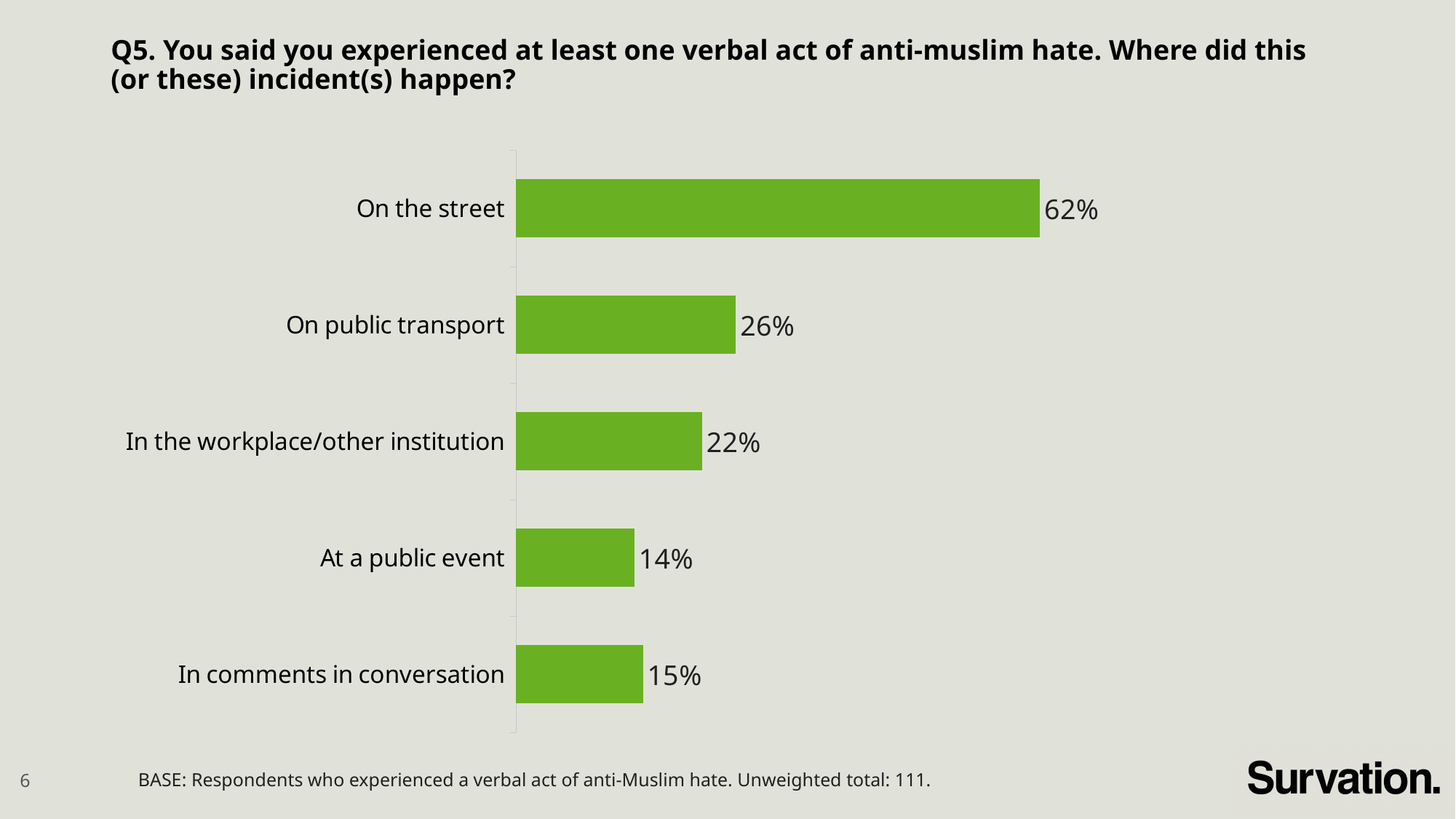
What kind of chart is shown on the slide? Bar chart What is the value for 'In comments in conversation'? 15% How many categories are shown in the chart? 5 What is the difference between the values for 'In comments in conversation' and 'At a public event'? 1% Which location has the lowest percentage? At a public event Which location has the highest percentage? On the street Which is larger: the value for 'On public transport' or 'In the workplace/other institution'? On public transport What is the difference between the values for 'On the street' and 'On public transport'? 36% What percentage is shown for 'In the workplace/other institution'? 22% What is the value for 'On public transport'? 26% What is the unweighted total of respondents stated in the base note? 111 What percentage of respondents said the incident(s) happened on the street? 62%